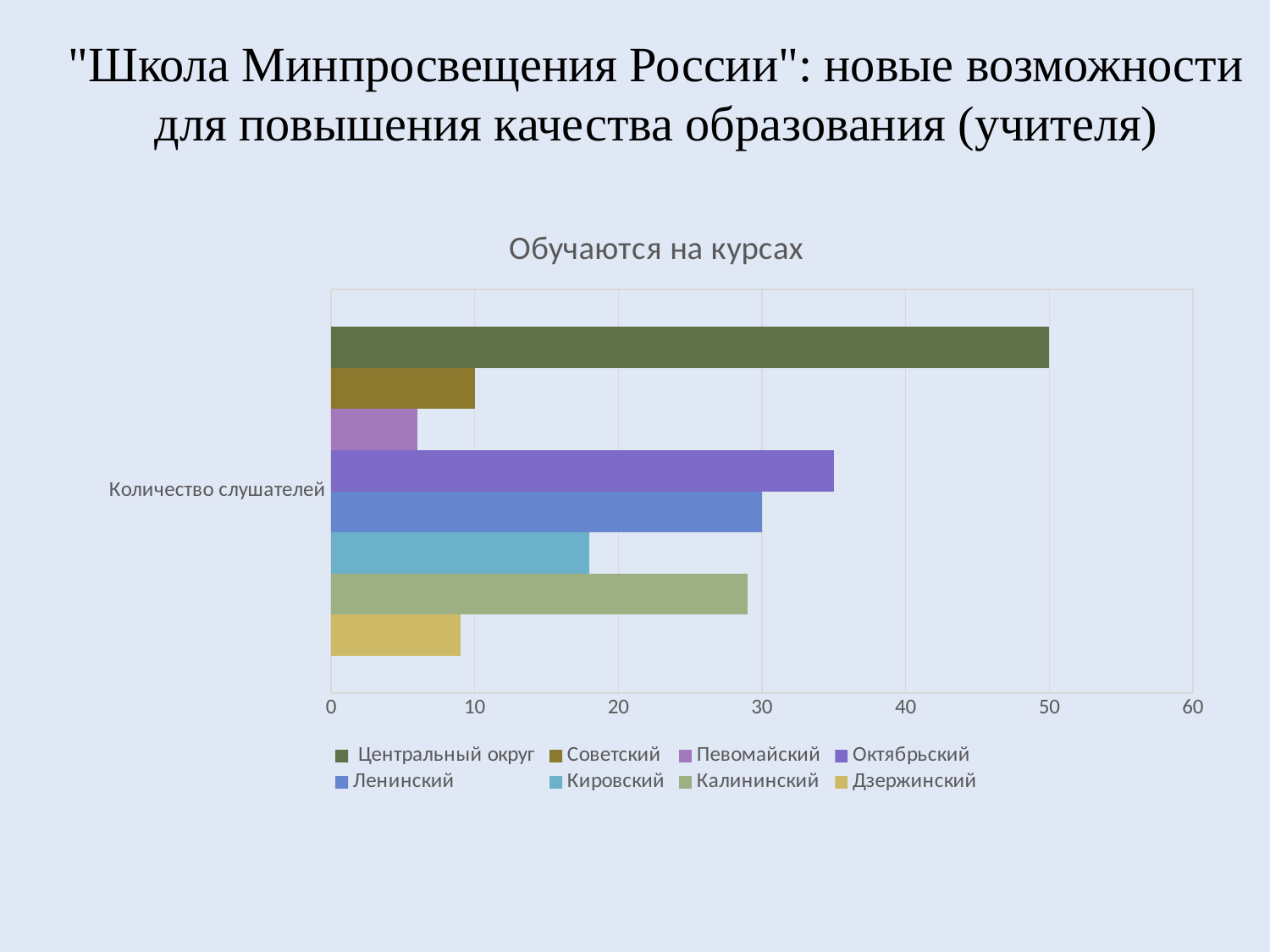
What is the value for Центральный округ? 50 What is the value for Ленинский? 30 Is the value for Октябрьский greater or less than 30? greater Which is larger, the value for Октябрьский or the value for Ленинский? Октябрьский Which series has the highest value? Центральный округ What is the difference between the values for Центральный округ and Ленинский? 20 How many series does the legend list? 8 Is the value for Кировский greater or less than 20? less What kind of chart is shown on the slide? bar chart Which series has the lowest value? Певомайский What is the value for Советский? 10 What is the title of the chart? Обучаются на курсах